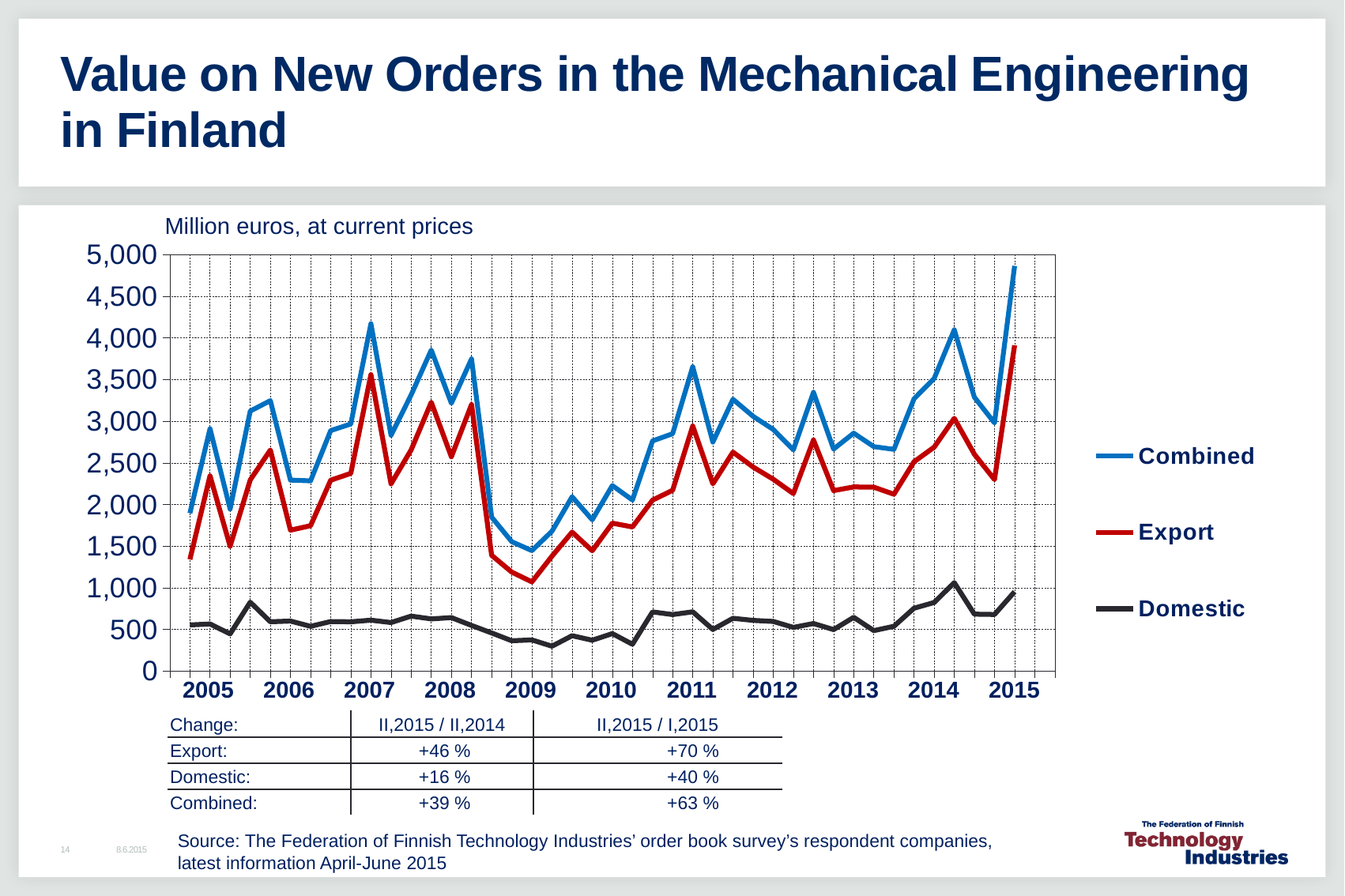
Which is larger in 2011, the Combined value or the Export value? Combined Which series has the lowest values throughout the chart? Domestic Is the Domestic value in 2009 greater or less than 500? less How many years are labelled on the x axis? 11 What unit is stated above the y axis? Million euros, at current prices In which year does the Combined series reach its lowest point? 2009 How many series does the legend list? 3 Does the Combined series rise or fall between 2008 and 2009? Fall Which series is drawn in red? Export What kind of chart is shown on the slide? Line chart Is the final 2015 value for Combined greater or less than 4,500? greater Is the final 2015 value for Export greater or less than 3,500? greater